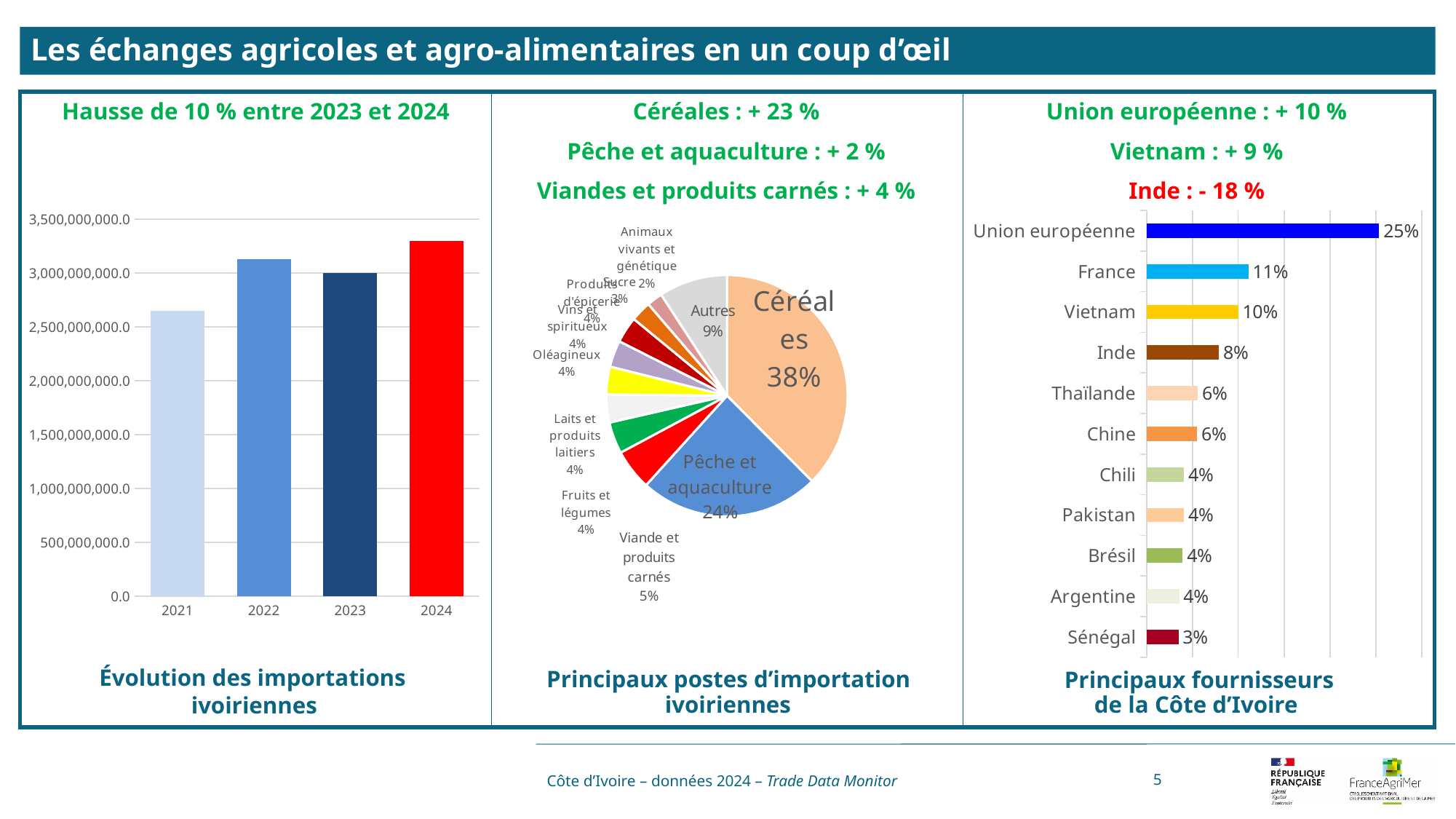
In the pie chart 'Principaux postes d'importation ivoiriennes', which is larger: Viande et produits carnés or Autres? Autres In the chart 'Évolution des importations ivoiriennes', is the value for 2024 greater or less than 3,000,000,000.0? greater In the pie chart 'Principaux postes d'importation ivoiriennes', what share do Céréales represent? 38% What kind of chart is 'Évolution des importations ivoiriennes'? Bar chart In the chart 'Principaux fournisseurs de la Côte d'Ivoire', what is the value for Inde? 8% In the chart 'Principaux fournisseurs de la Côte d'Ivoire', which supplier has the lowest share? Sénégal In the chart 'Principaux fournisseurs de la Côte d'Ivoire', what is the difference between the values for Union européenne and France? 14% In the chart 'Évolution des importations ivoiriennes', which year has the lowest value? 2021 In the chart 'Principaux fournisseurs de la Côte d'Ivoire', which supplier has the highest share? Union européenne In the chart 'Principaux fournisseurs de la Côte d'Ivoire', what is the value for Vietnam? 10% In the chart 'Principaux fournisseurs de la Côte d'Ivoire', how many suppliers are listed? 11 In the pie chart 'Principaux postes d'importation ivoiriennes', what share does Pêche et aquaculture represent? 24%